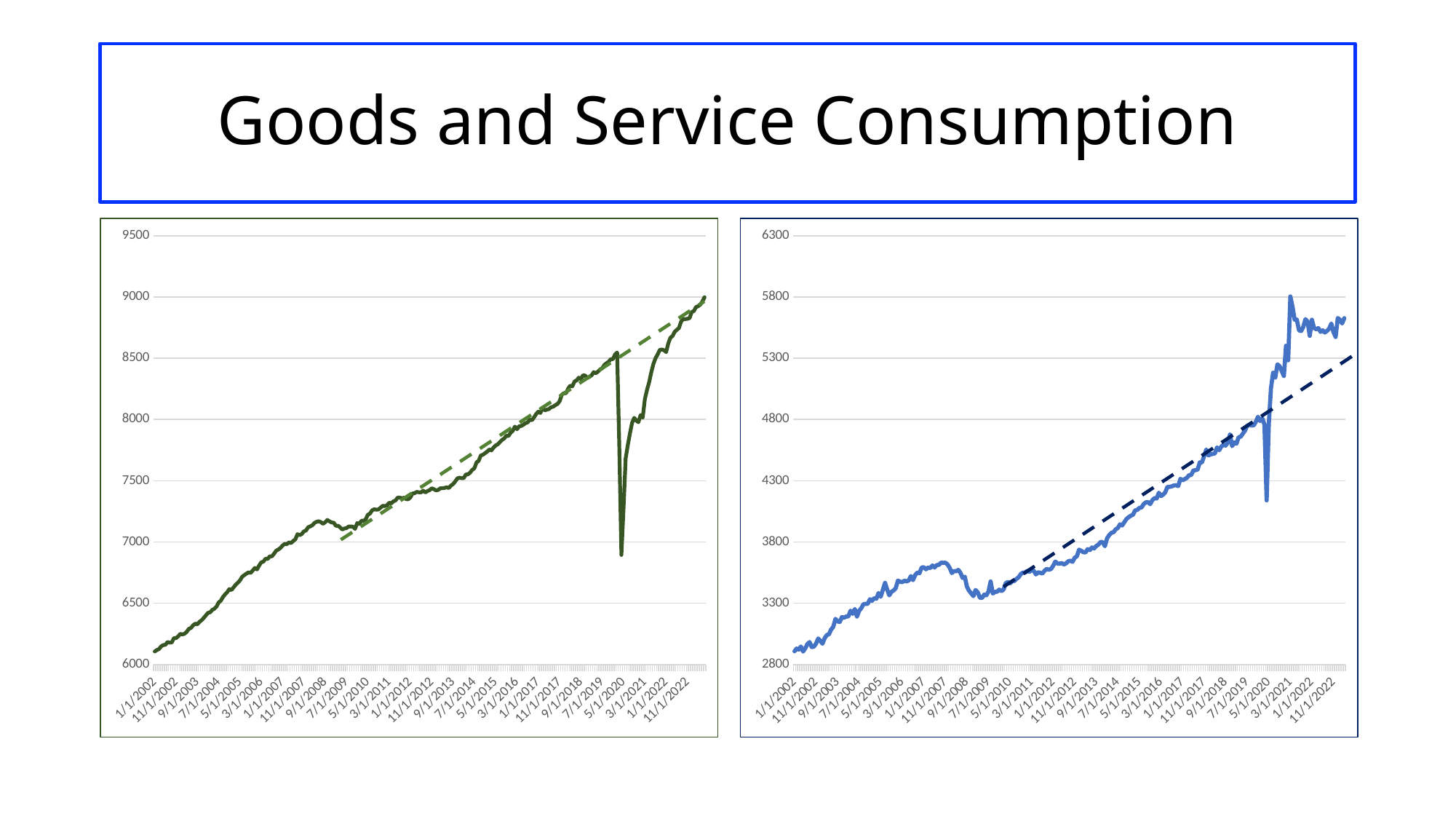
In the chart on the right, is the value at 1/1/2002 greater or less than 3300? less In the chart on the left, is the lowest point of the sharp dip in 2020 greater or less than 7500? less What is the title of the slide? Goods and Service Consumption In the chart on the right, is the value at the end of the series in late 2022 greater or less than 5300? greater In the chart on the right, do the values generally rise or fall from 1/1/2002 to 11/1/2022? rise In the chart on the left, which is larger: the value at 1/1/2002 or the value at the end of the series in late 2022? the value in late 2022 In the chart on the left, do the values generally rise or fall from 1/1/2002 to 11/1/2022? rise What kind of chart is the chart on the left of the slide? line chart What kind of chart is the chart on the right of the slide? line chart